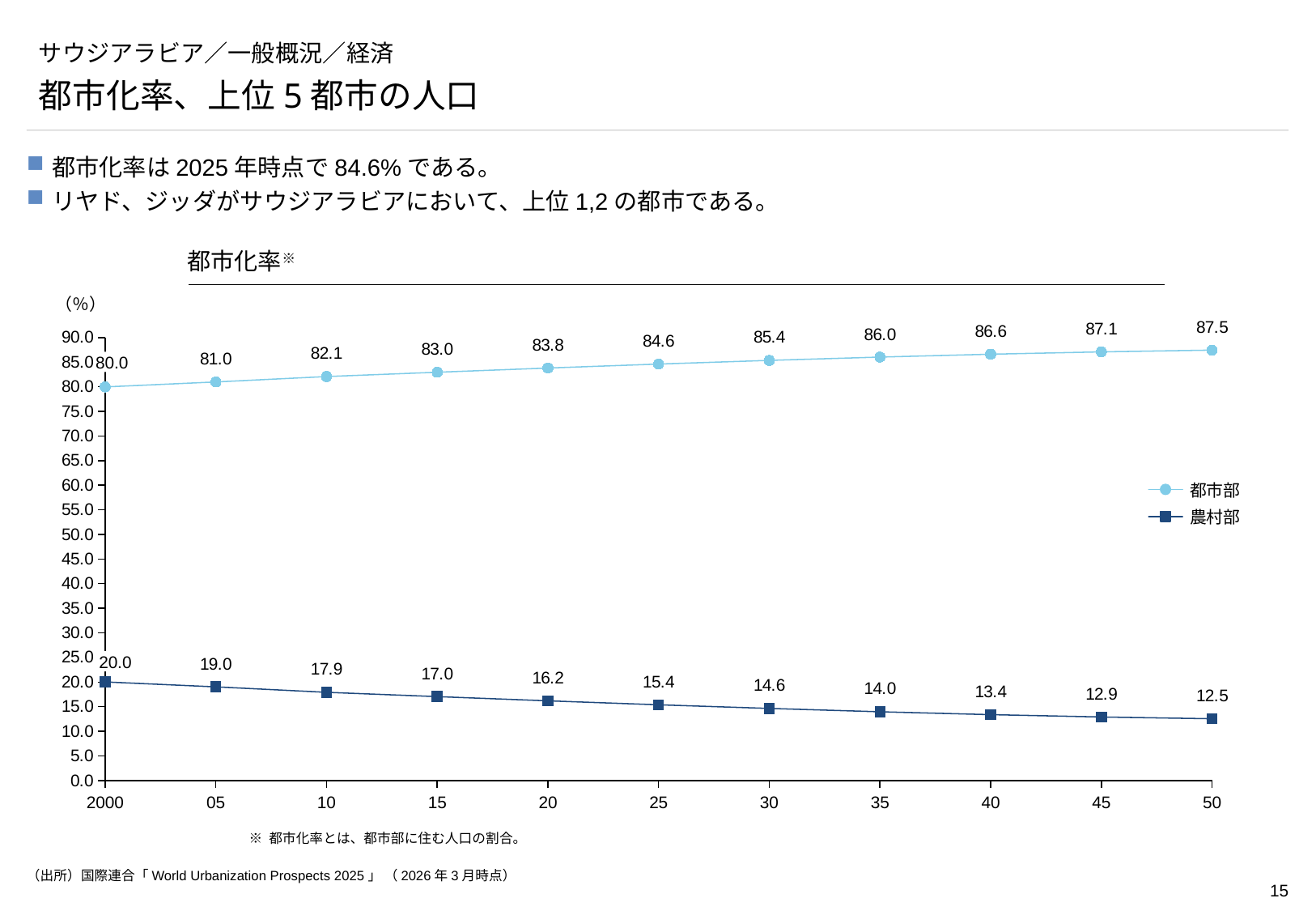
Which is larger in 2030: the 都市部 value or the 農村部 value? 都市部 What is the value for 都市部 in 2025? 84.6 Does the 農村部 series rise or fall from 2000 to 2050? Fall In which year is 農村部 at its lowest value? 2050 (50) What is the value for 農村部 in 2000? 20.0 What kind of chart is shown? Line chart What is the difference between the 都市部 value in 2050 and in 2000? 7.5 In which year does 都市部 reach its highest value? 2050 (50) What is the value for 農村部 in 2050 (labelled 50)? 12.5 How many years (data points) are plotted on the x axis? 11 How many series does the legend list? 2 Is the value for 都市部 in 2000 greater or less than 75.0? greater